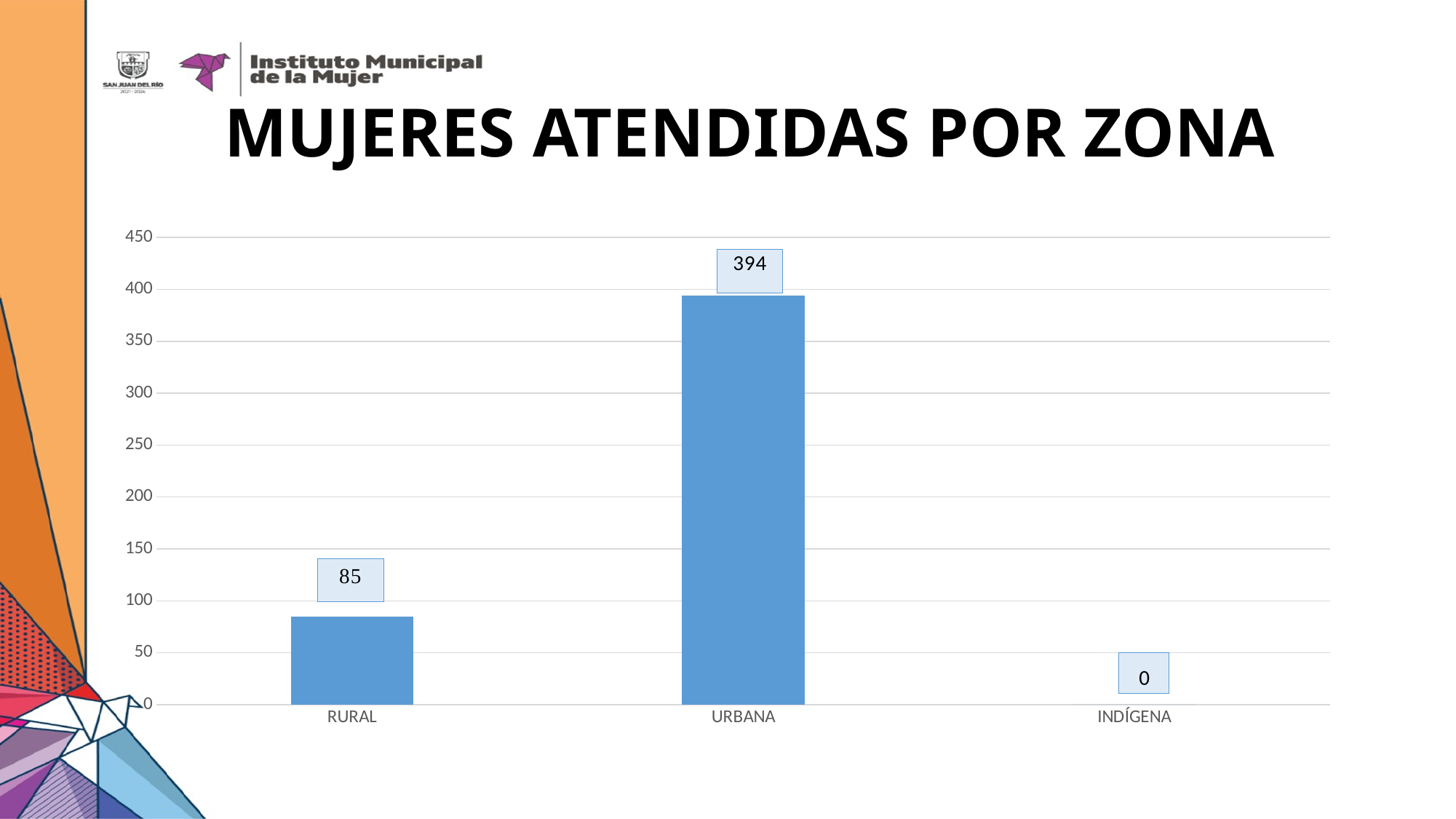
What is the value for INDÍGENA? 0 Is the value for RURAL greater or less than 100? less Which category has the highest value? URBANA Which is larger, the value for RURAL or the value for URBANA? URBANA What is the value for URBANA? 394 What is the difference between the values for URBANA and RURAL? 309 What is the value for RURAL? 85 What kind of chart is shown on the slide? bar chart What is the title of the slide above the chart? MUJERES ATENDIDAS POR ZONA How many categories are shown on the x axis? 3 Which category has the lowest value? INDÍGENA Is the value for URBANA greater or less than 350? greater